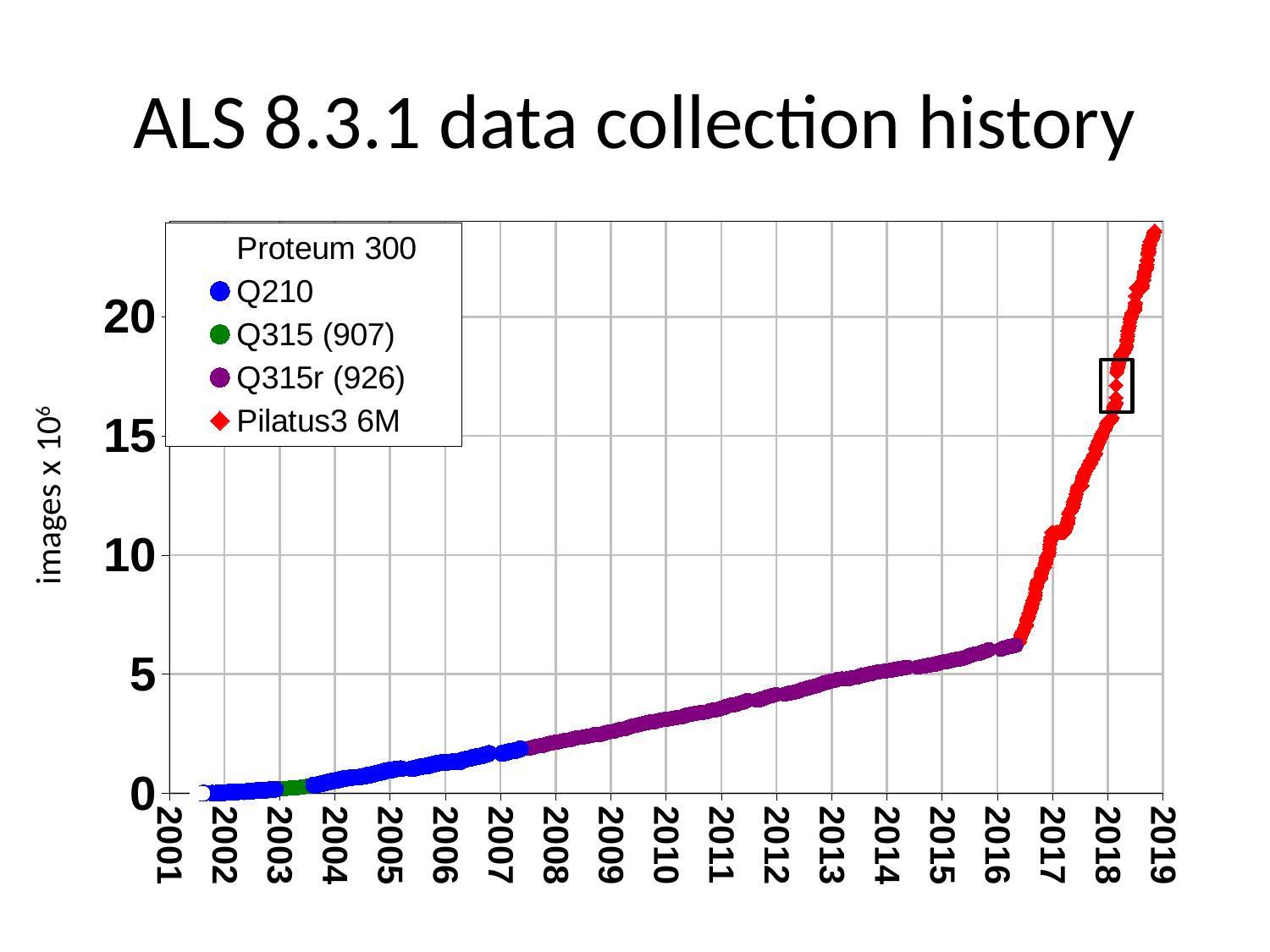
How many entries does the chart legend list? 5 Which is larger, the value in 2018 or the value in 2010? 2018 What kind of chart is shown on the slide? scatter chart Do the plotted values rise or fall as the years increase along the x axis? rise Is the value at the start of 2018 greater or less than 15? greater Is the value at the start of 2017 greater or less than 10? greater Is the value at the end of the series in 2019 greater or less than 20? greater Which legend series is plotted with red diamond markers? Pilatus3 6M How many year labels are shown along the x axis? 19 What is the title of the chart? ALS 8.3.1 data collection history